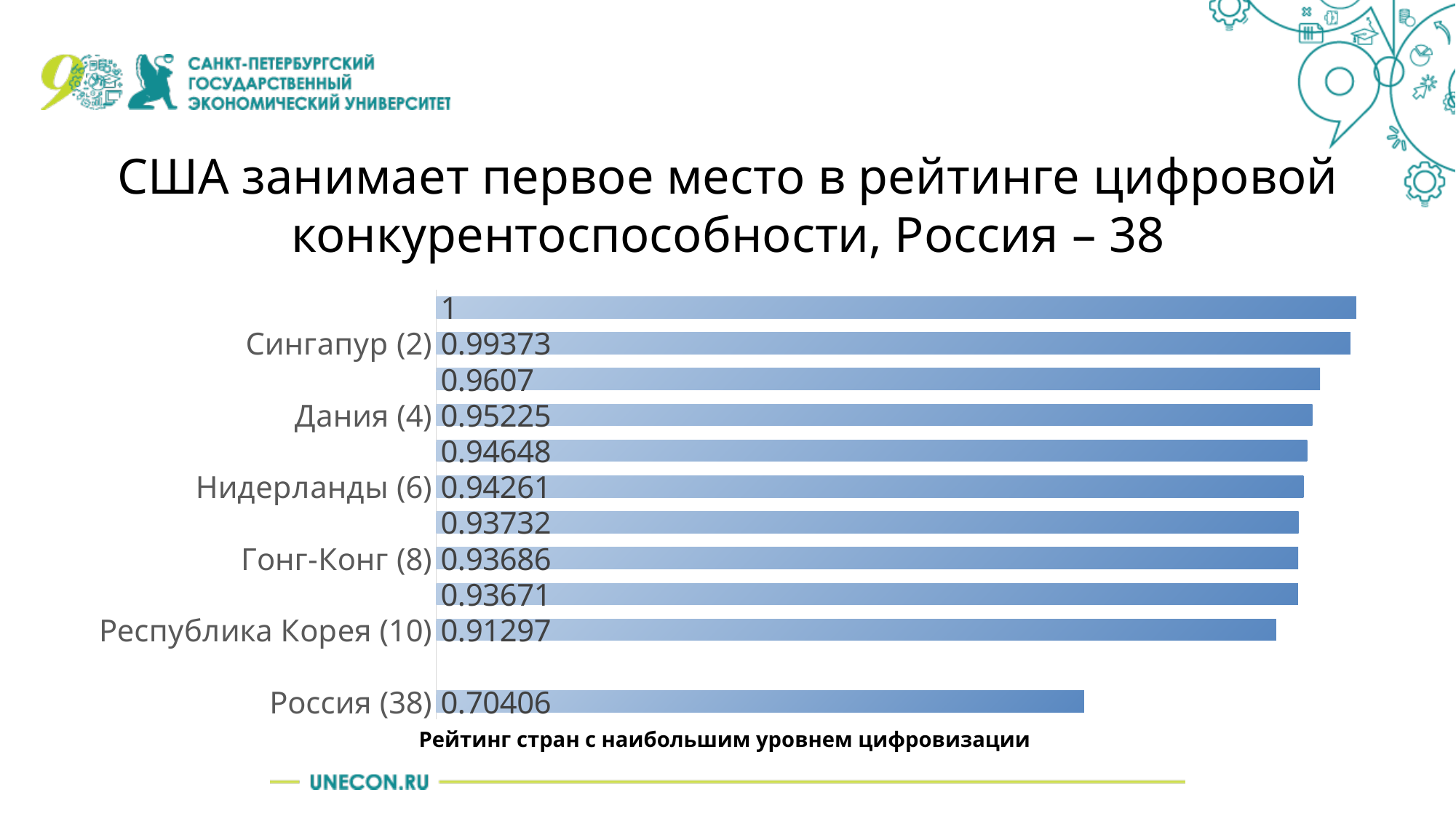
What is the value for Гонг-Конг (8)? 0.93686 What is the value for Сингапур (2)? 0.99373 How many bars are plotted in the chart? 11 Which labelled country has the lowest value in the chart? Россия (38) Which has a larger value, Сингапур (2) or Дания (4)? Сингапур (2) What is the value for Республика Корея (10)? 0.91297 What is the value for Россия (38)? 0.70406 What is the highest value shown in the chart? 1 What kind of chart is shown on the slide? Bar chart What is the value for Нидерланды (6)? 0.94261 What is the difference between the values for Сингапур (2) and Россия (38)? 0.28967 What is the value for Дания (4)? 0.95225